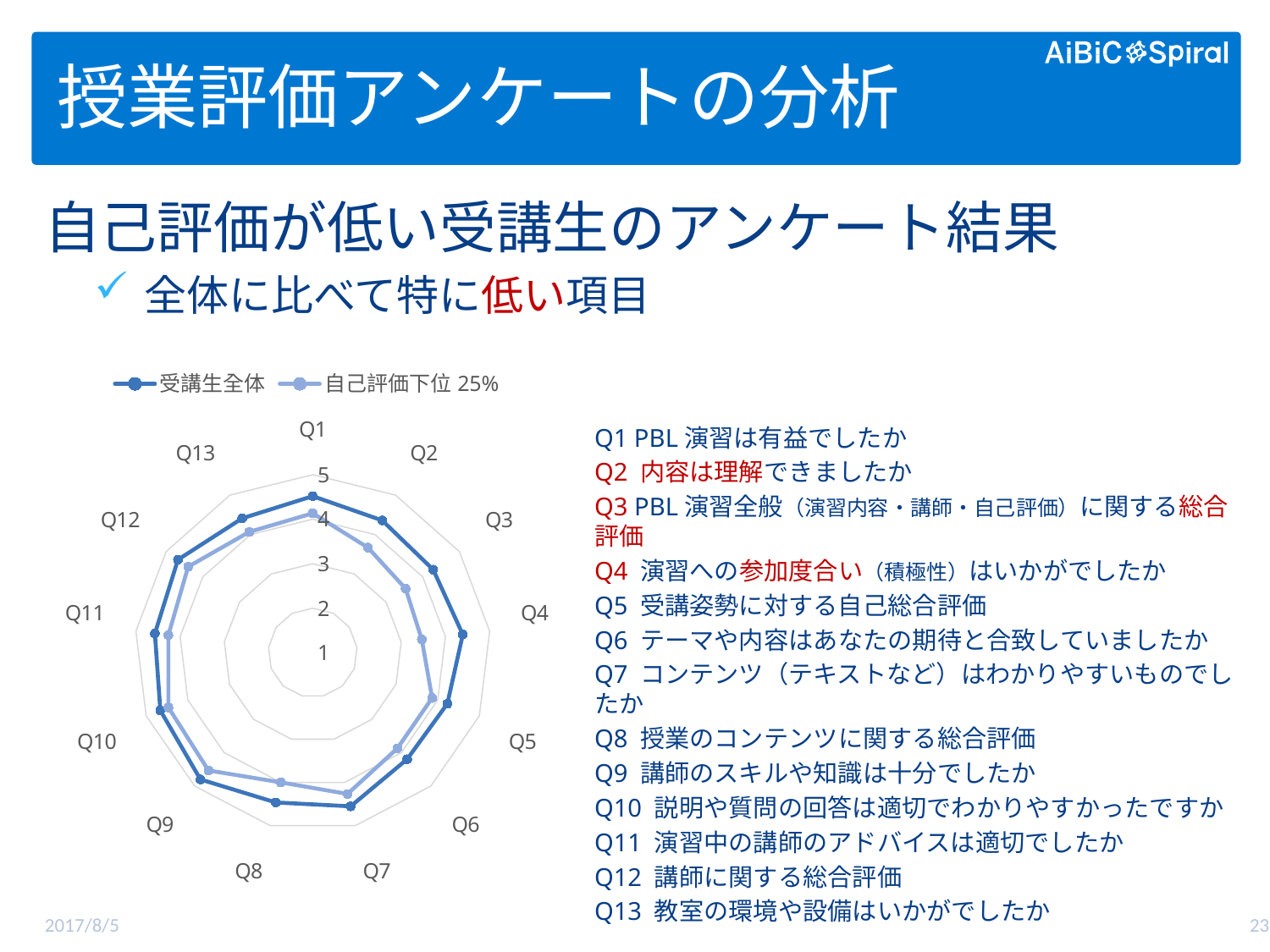
What is the highest value shown on the radar chart's scale? 5 For Q4, which series has the larger value, 受講生全体 or 自己評価下位 25%? 受講生全体 How many categories (axes) does the radar chart have? 13 Is the value of 受講生全体 for Q1 greater or less than 4? greater How many series does the chart legend list? 2 What are the two series named in the chart legend? 受講生全体 and 自己評価下位 25% Is the value of 自己評価下位 25% for Q10 greater or less than 4? greater Is the value of 受講生全体 for Q9 greater or less than 5? less What kind of chart is shown on the slide? Radar chart For Q3, which series has the larger value, 受講生全体 or 自己評価下位 25%? 受講生全体 For Q1, which series has the larger value, 受講生全体 or 自己評価下位 25%? 受講生全体